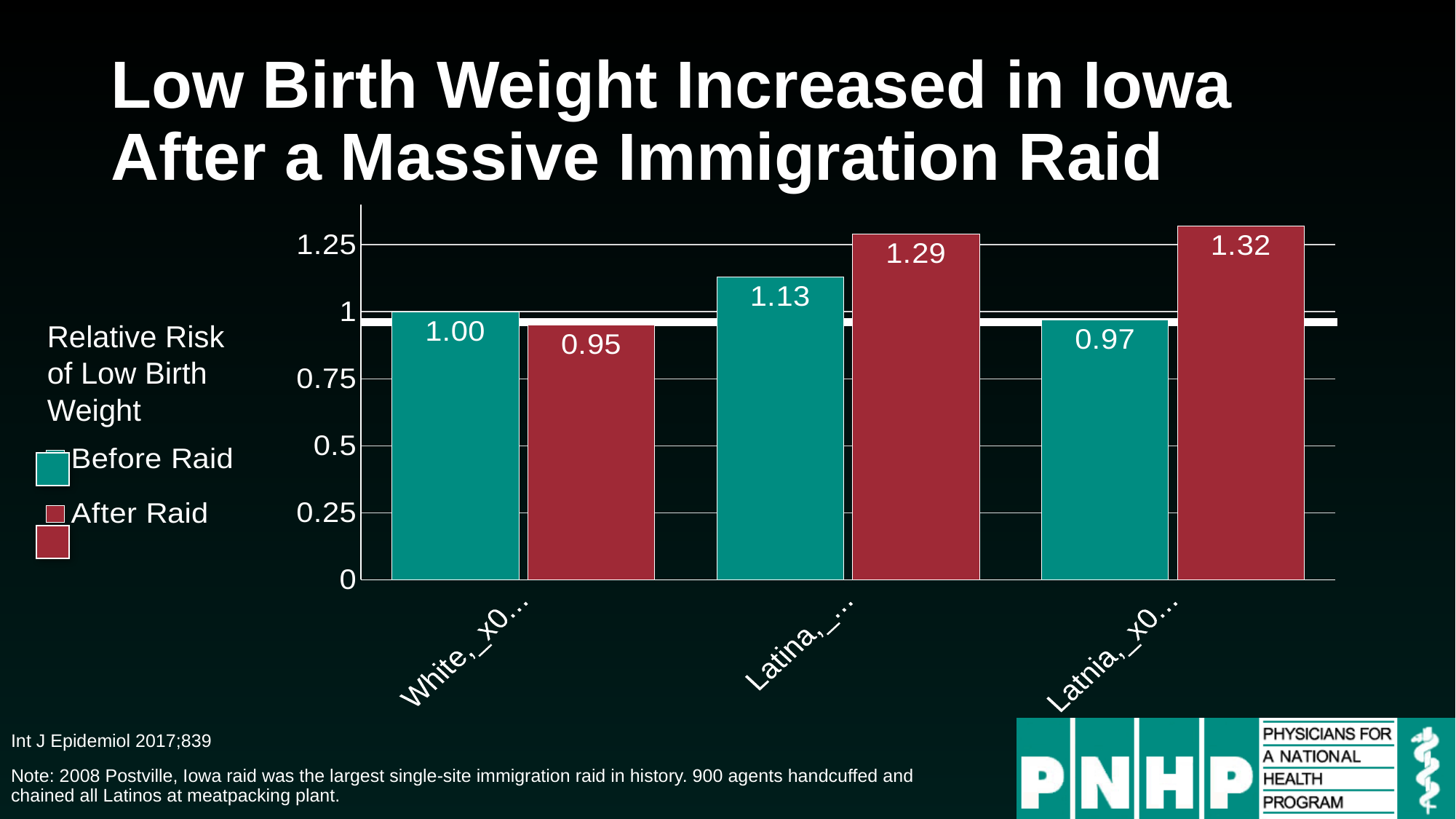
How many series does the legend list? 2 What is the Before Raid value for the middle group of bars? 1.13 For the White group, which is larger: the Before Raid value or the After Raid value? Before Raid What is the Before Raid value for the White group? 1.00 What is the After Raid value for the rightmost group of bars? 1.32 In the middle group of bars, how much higher is the After Raid value than the Before Raid value? 0.16 How many groups of bars are shown on the chart? 3 What is the After Raid value for the White group? 0.95 What kind of chart is shown on the slide? Bar chart What is the highest value shown on the chart? 1.32 What is the lowest value shown on the chart? 0.95 In the rightmost group of bars, what is the difference between the After Raid and Before Raid values? 0.35